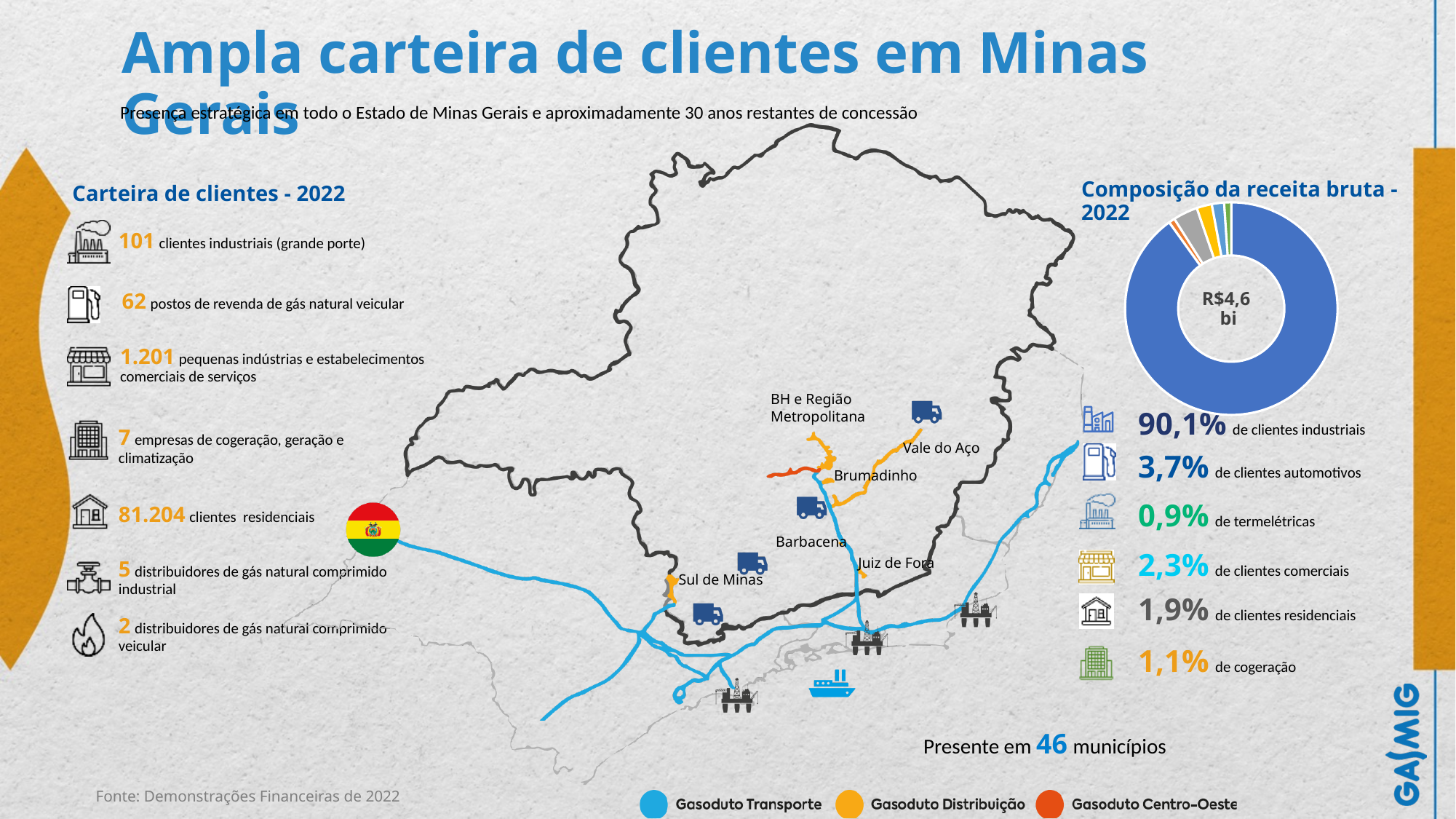
In the 'Composição da receita bruta - 2022' chart, what share comes from clientes automotivos? 3,7% In the 'Composição da receita bruta - 2022' chart, what share comes from termelétricas? 0,9% In the 'Composição da receita bruta - 2022' chart, which share is larger: clientes comerciais or clientes residenciais? Clientes comerciais Which category has the largest share in the 'Composição da receita bruta - 2022' chart? Clientes industriais In the 'Composição da receita bruta - 2022' chart, how many percentage points larger is the share of clientes industriais than that of clientes automotivos? 86,4 percentage points In the 'Composição da receita bruta - 2022' chart, what share comes from clientes comerciais? 2,3% What kind of chart is 'Composição da receita bruta - 2022'? Donut (pie) chart Which category has the smallest share in the 'Composição da receita bruta - 2022' chart? Termelétricas In the 'Composição da receita bruta - 2022' chart, what share comes from clientes residenciais? 1,9% In the 'Composição da receita bruta - 2022' chart, what share of gross revenue comes from clientes industriais? 90,1% In the 'Composição da receita bruta - 2022' chart, what share comes from cogeração? 1,1% How many revenue categories are listed for the 'Composição da receita bruta - 2022' chart? 6